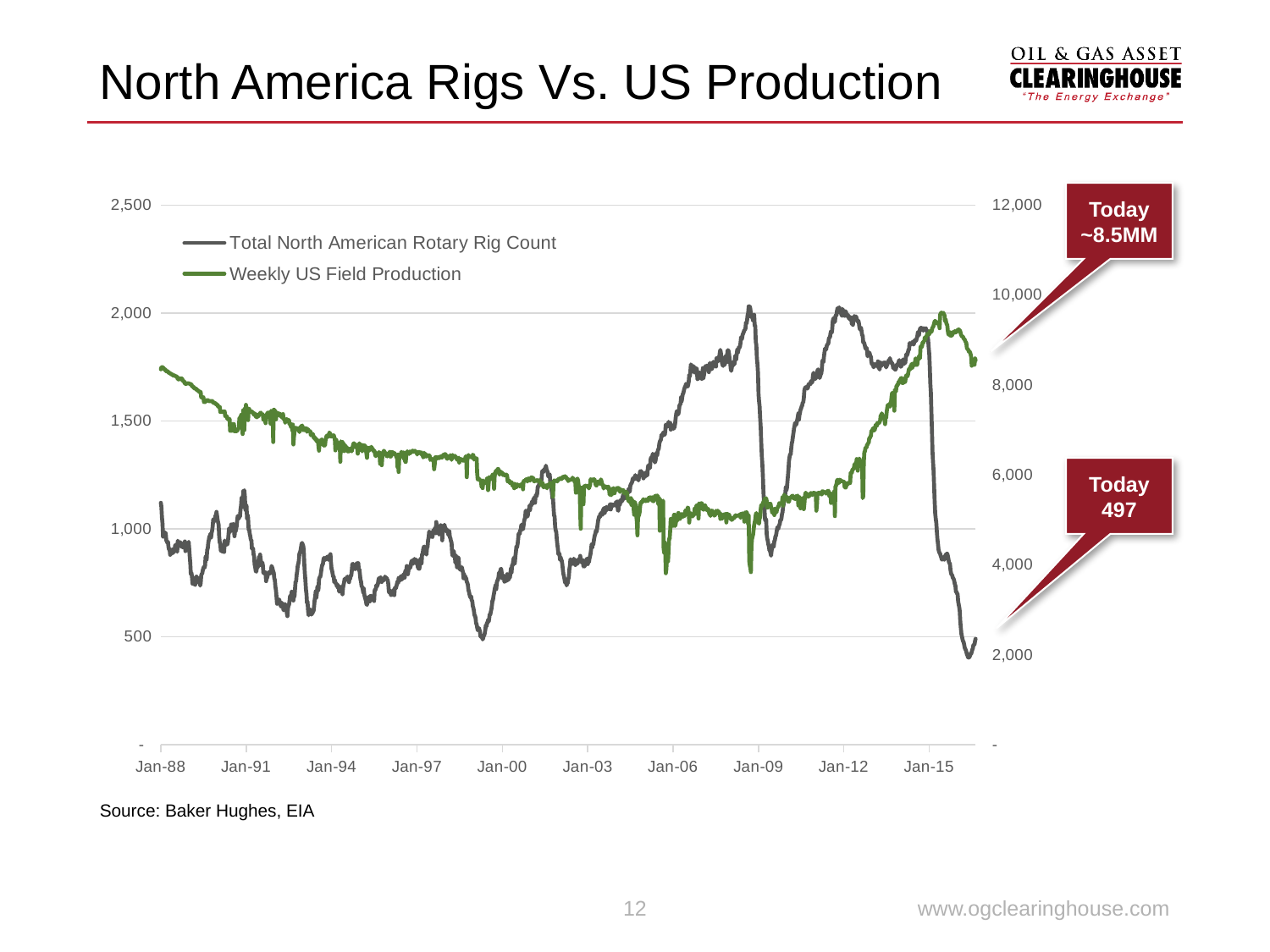
Is the Total North American Rotary Rig Count around Jan-09 greater or less than 1,500? greater Is the Weekly US Field Production around Jan-09 greater or less than 6,000 on the right axis? less What value does the 'Today' callout give for the rig count? 497 Is the Total North American Rotary Rig Count around Jan-00 greater or less than 1,000? less What value does the 'Today' callout give for US field production? ~8.5MM Does the Total North American Rotary Rig Count rise or fall after Jan-15? fall How many series does the legend list? 2 What is the title of the chart? North America Rigs Vs. US Production Does the Weekly US Field Production rise or fall between Jan-88 and Jan-09? fall What kind of chart is shown on the slide? line chart Which series is drawn in green? Weekly US Field Production